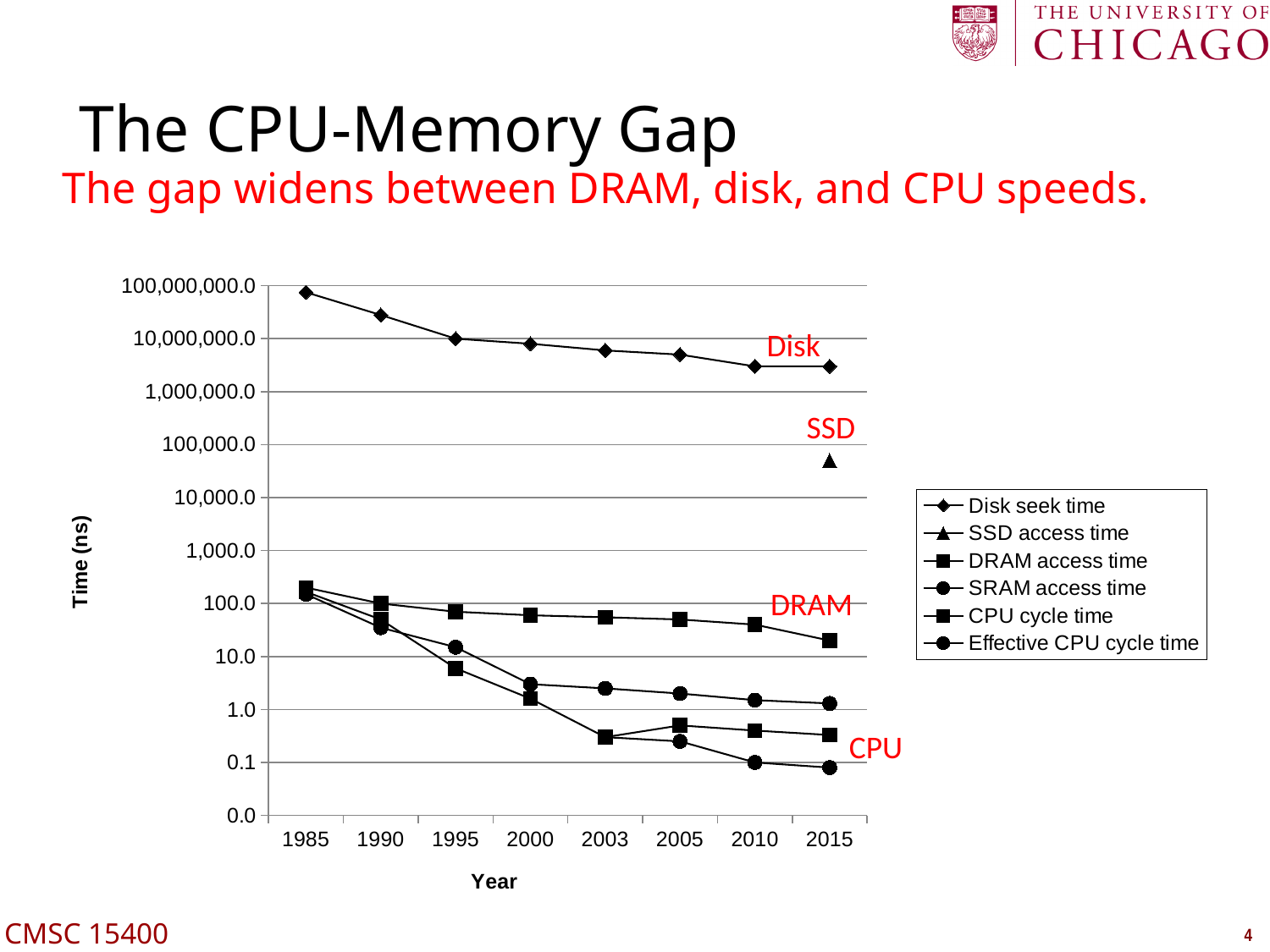
How many years are plotted along the x axis? 8 Is the CPU cycle time value for 2015 greater or less than 1.0? less Is the SSD access time value for 2015 greater or less than 100,000.0? less Does the Disk seek time rise or fall from 1985 to 2015? fall In 2015, which is larger: Disk seek time or DRAM access time? Disk seek time What kind of chart is shown on the slide? line chart How many series does the legend list? 6 What is the label on the y axis? Time (ns) Is the Disk seek time value for 1985 greater or less than 10,000,000.0? greater Which series has the highest values across all years? Disk seek time